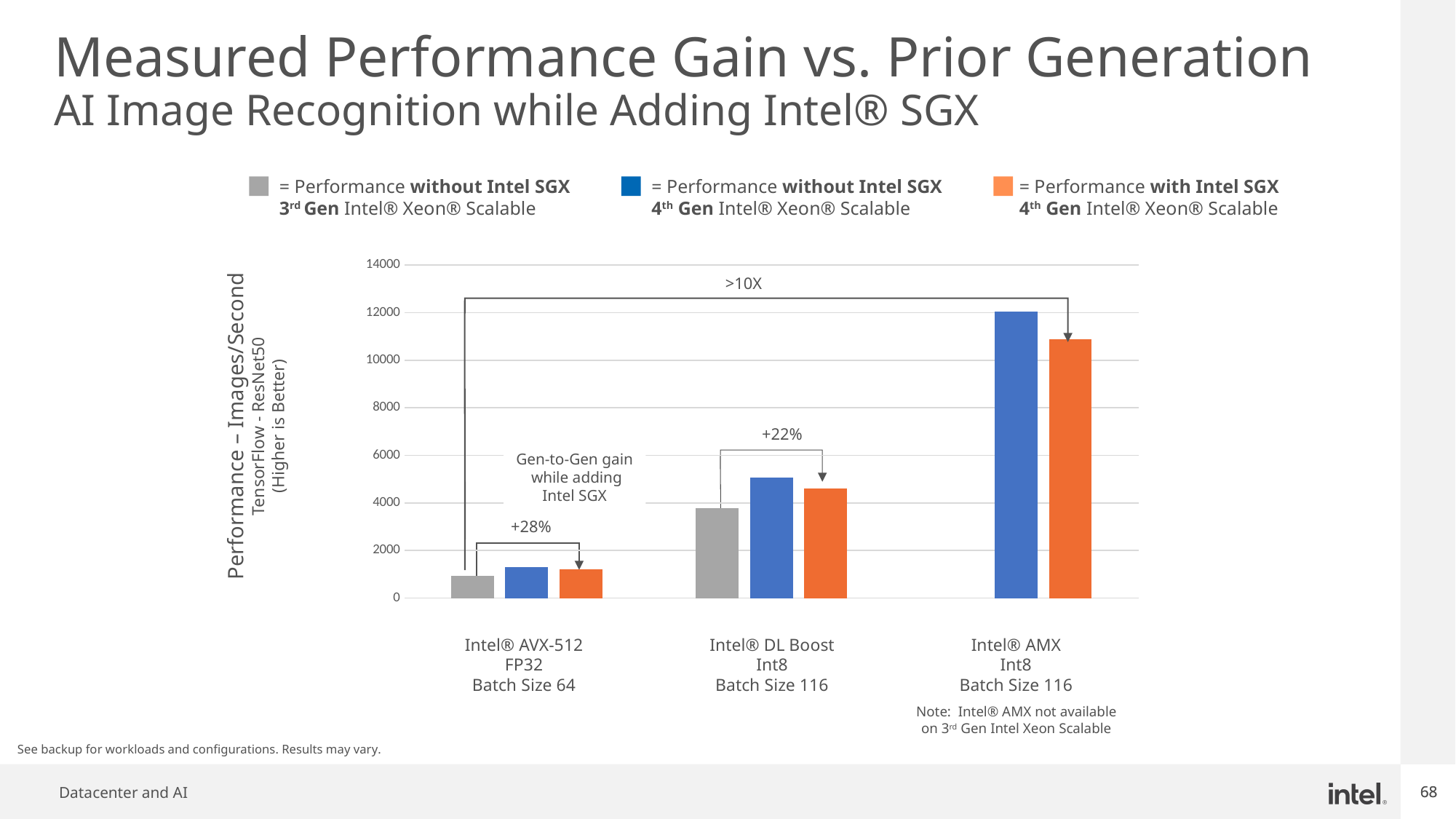
How many categories are shown along the x axis of the chart? 3 Is the value for Intel AMX without Intel SGX on 4th Gen Intel Xeon Scalable greater or less than 10000? greater For Intel AMX, which is larger: performance without Intel SGX or performance with Intel SGX on 4th Gen Intel Xeon Scalable? Performance without Intel SGX Is the value for Intel DL Boost without Intel SGX on 4th Gen Intel Xeon Scalable greater or less than 6000? less What gen-to-gen gain is annotated above the Intel AVX-512 FP32 Batch Size 64 bars? +28% What gain is annotated by the long arrow from the Intel AVX-512 bars to the Intel AMX bars? >10X How many series does the legend list? 3 What kind of chart is shown on the slide? Bar chart What gen-to-gen gain is annotated above the Intel DL Boost Int8 Batch Size 116 bars? +22% Which category has the shortest bar in the chart? Intel AVX-512 FP32 Batch Size 64 Which series is shown in orange in the legend? Performance with Intel SGX, 4th Gen Intel Xeon Scalable Which category has the tallest bar in the chart? Intel AMX Int8 Batch Size 116